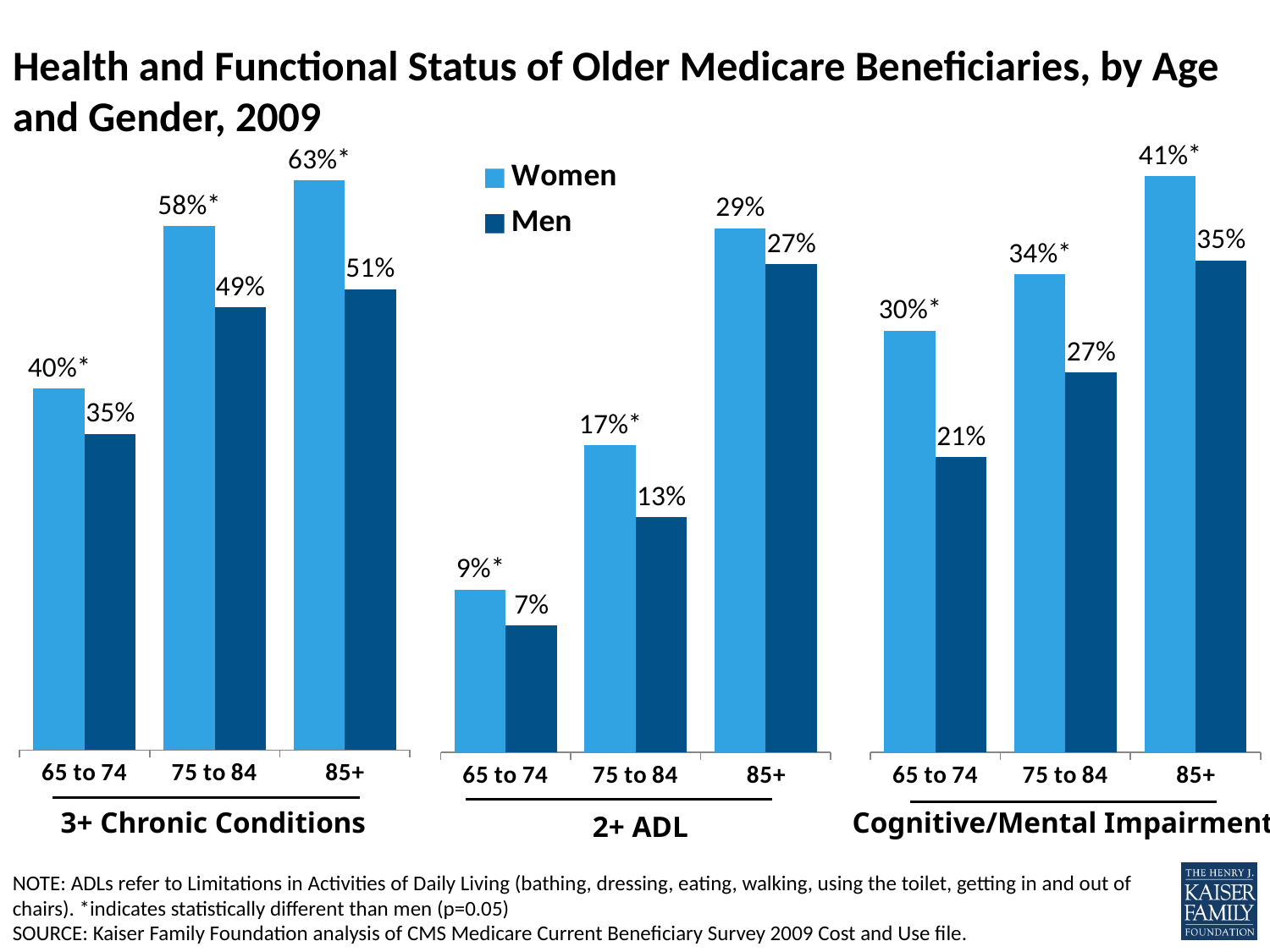
How many series does the legend list? 2 In the Cognitive/Mental Impairment chart, which is larger for the 65 to 74 age group, women or men? Women In the 3+ Chronic Conditions chart, what is the value for women aged 65 to 74? 40% In the 2+ ADL chart, what is the difference between women and men aged 85+? 2 percentage points In the Cognitive/Mental Impairment chart, what is the value for women aged 75 to 84? 34% In the 2+ ADL chart, do the values for men rise or fall as age increases from 65 to 74 to 85+? Rise In the 2+ ADL chart, what is the value for men aged 65 to 74? 7% In the Cognitive/Mental Impairment chart, which age group has the lowest value for men? 65 to 74 In the 3+ Chronic Conditions chart, what is the difference between women and men aged 75 to 84? 9 percentage points What kind of chart is used on this slide? Bar chart In the 3+ Chronic Conditions chart, what is the value for men aged 85+? 51% In the 2+ ADL chart, which age group has the highest value for women? 85+